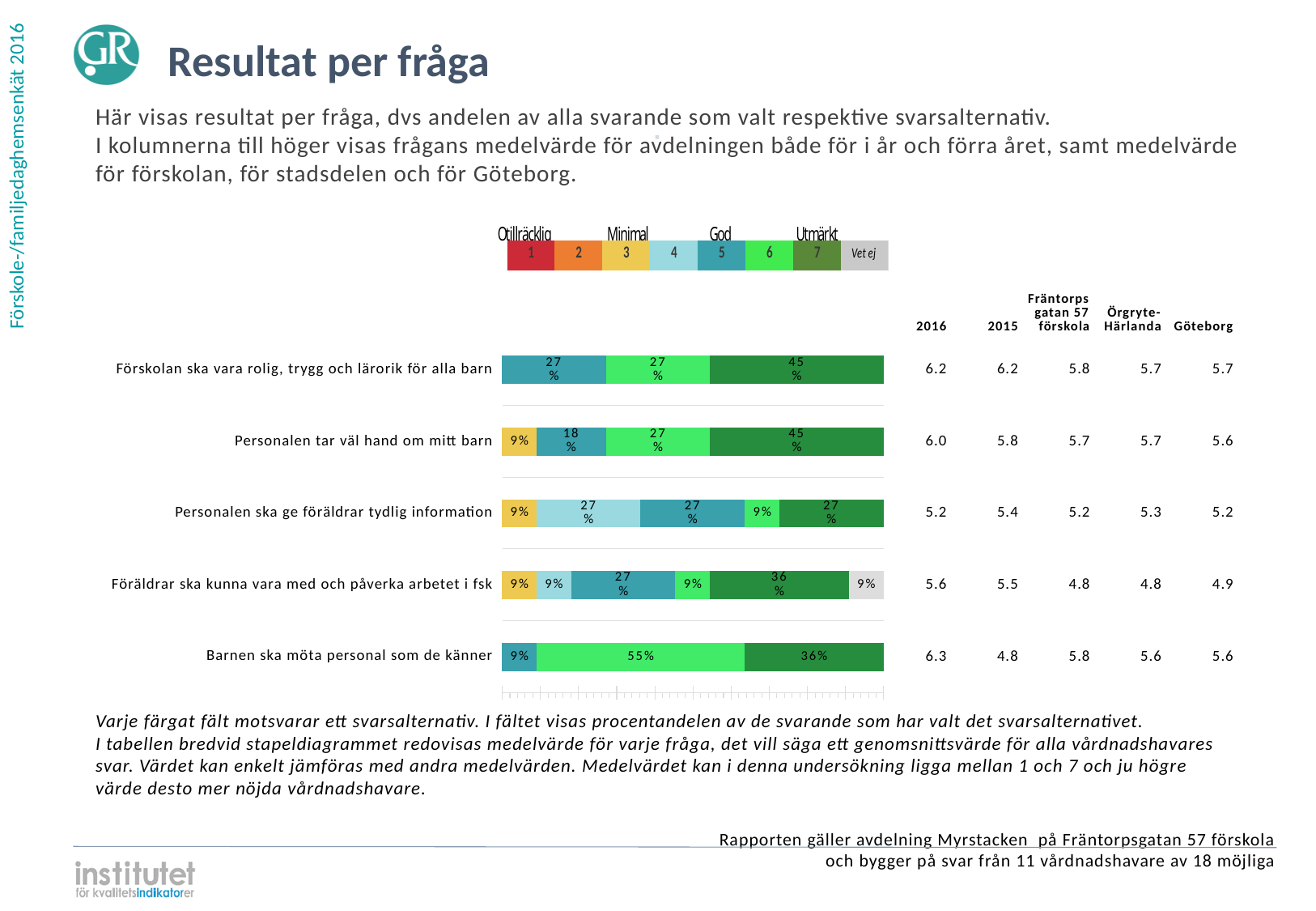
For "Barnen ska möta personal som de känner", how many percentage points larger is the option 6 segment than the option 7 segment? 19 What percentage of respondents chose option 7 (dark green) for "Förskolan ska vara rolig, trygg och lärorik för alla barn"? 45% What percentage of respondents chose option 3 (yellow) for "Personalen tar väl hand om mitt barn"? 9% How many response options does the legend above the chart list? 8 What is the "Vet ej" share for "Föräldrar ska kunna vara med och påverka arbetet i fsk"? 9% What percentage of respondents chose option 7 (dark green) for "Barnen ska möta personal som de känner"? 36% Which question has the largest single segment in its bar? Barnen ska möta personal som de känner What kind of chart is used to show the results per question? Stacked bar chart What percentage of respondents chose option 6 (light green) for "Barnen ska möta personal som de känner"? 55% How many questions (categories) are shown as bars in the chart? 5 For "Personalen ska ge föräldrar tydlig information", which is larger: the option 4 (light blue) segment or the option 6 (light green) segment? Option 4 (27%) Which question's bar includes a grey "Vet ej" segment? Föräldrar ska kunna vara med och påverka arbetet i fsk